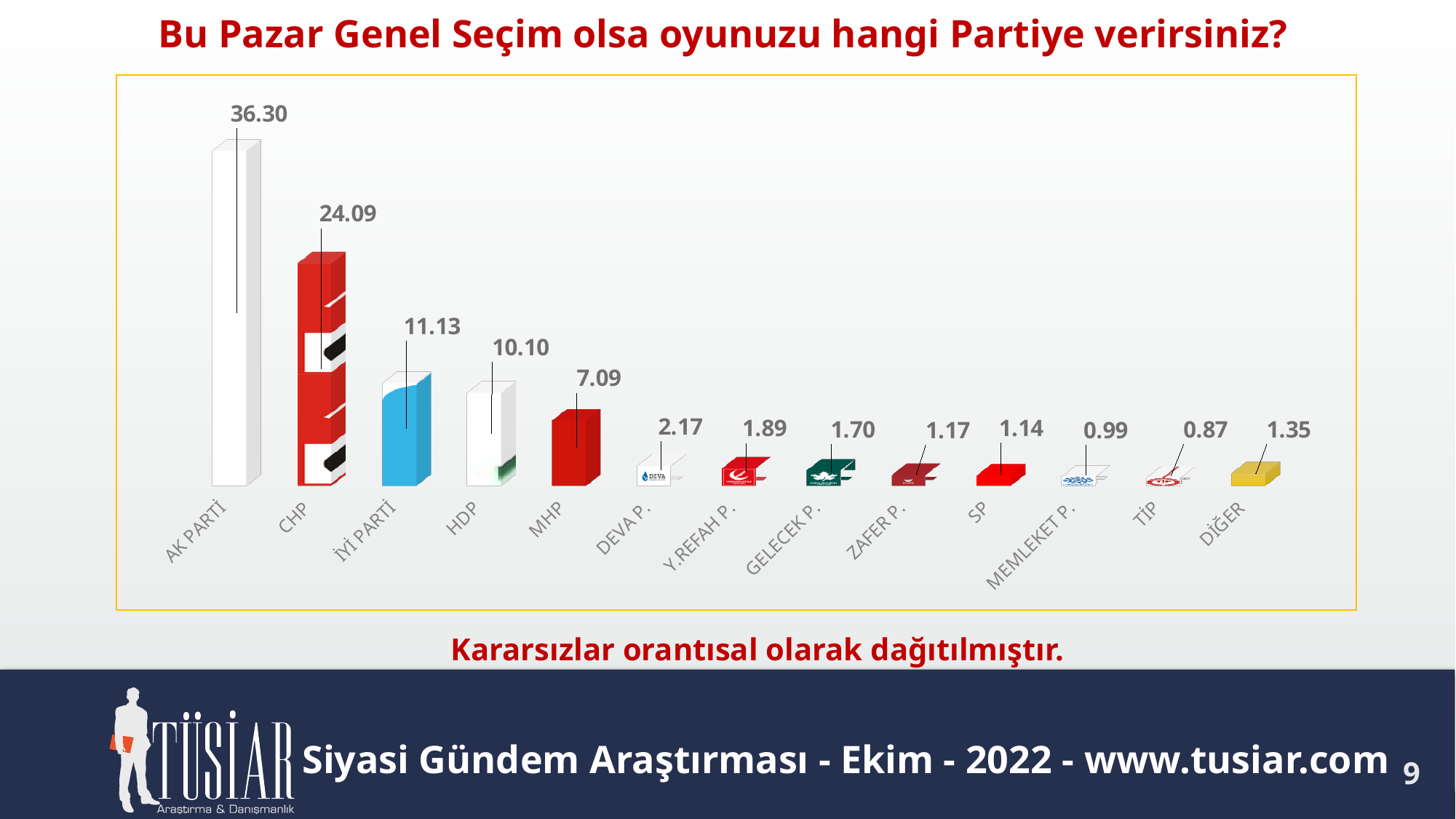
What kind of chart is shown on the slide? Bar chart Which is larger, the value for DEVA P. or the value for Y.REFAH P.? DEVA P. Which party has the highest value? AK PARTİ What is the value for DİĞER? 1.35 What is the title of the slide above the chart? Bu Pazar Genel Seçim olsa oyunuzu hangi Partiye verirsiniz? What is the value for CHP? 24.09 How many categories are shown on the chart? 13 What is the value for AK PARTİ? 36.30 What is the difference between the values for AK PARTİ and CHP? 12.21 What is the value for MHP? 7.09 What is the difference between the values for İYİ PARTİ and HDP? 1.03 Which category has the lowest value? TİP